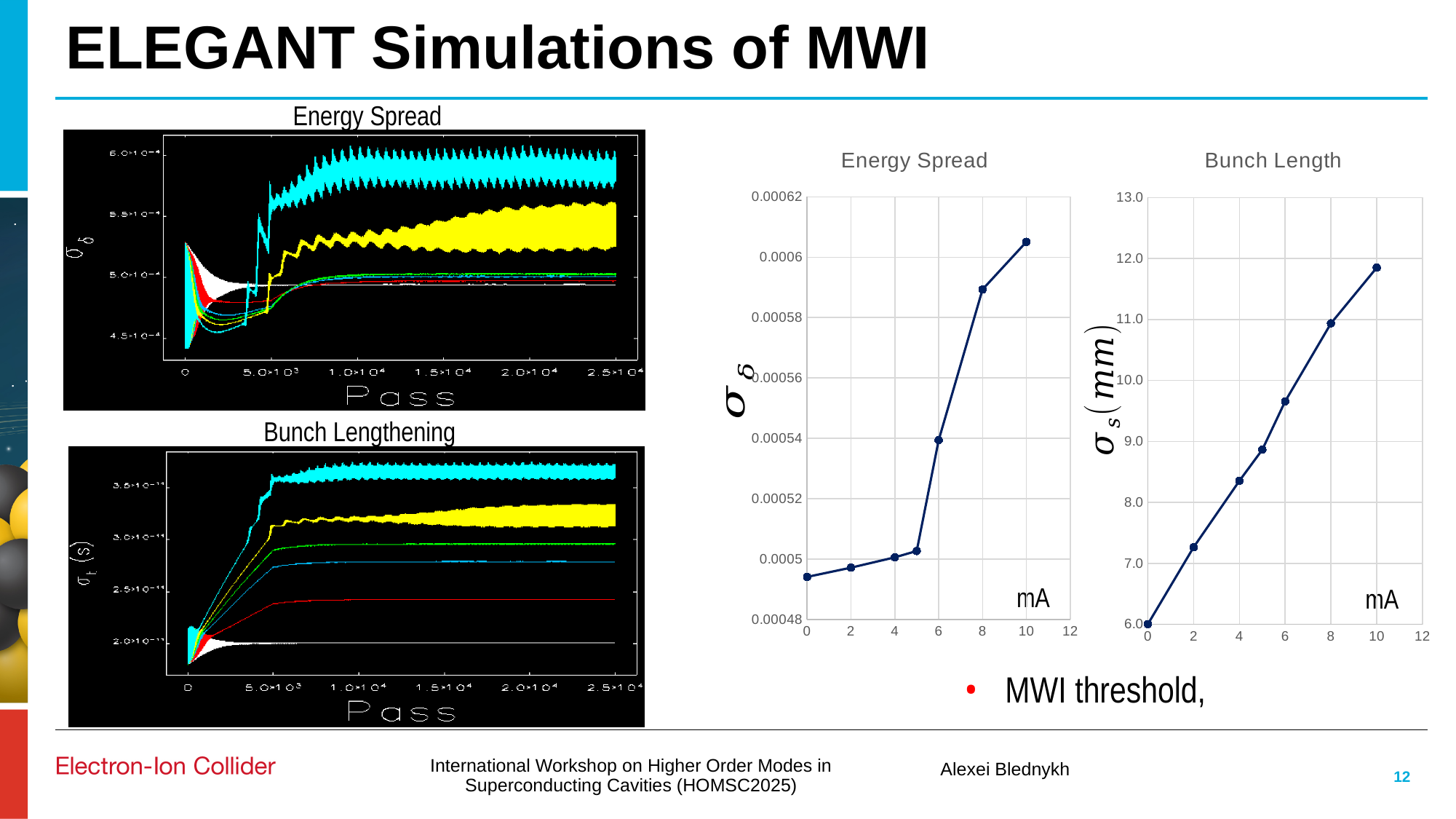
On the Bunch Length chart, at which current (mA) is the bunch length lowest? 0 On the Bunch Length chart, is the value at 8 mA greater or less than 10.0? greater On the Bunch Length chart, do the values rise or fall as the current in mA increases? rise On the Energy Spread chart on the right side of the slide, is the value at 6 mA greater or less than 0.00056? less On the Energy Spread chart on the right side of the slide, at which current (mA) is the energy spread highest? 10 How many data points are plotted on the Bunch Length chart? 7 On the Bunch Length chart, is the value at 2 mA greater or less than 8.0? less How many data points are plotted on the Energy Spread chart on the right side of the slide? 7 On the Energy Spread chart on the right side of the slide, do the values rise or fall as the current in mA increases? rise What kind of chart is the Energy Spread chart on the right side of the slide? line chart On the Energy Spread chart on the right side of the slide, which is larger: the value at 8 mA or the value at 5 mA? 8 mA